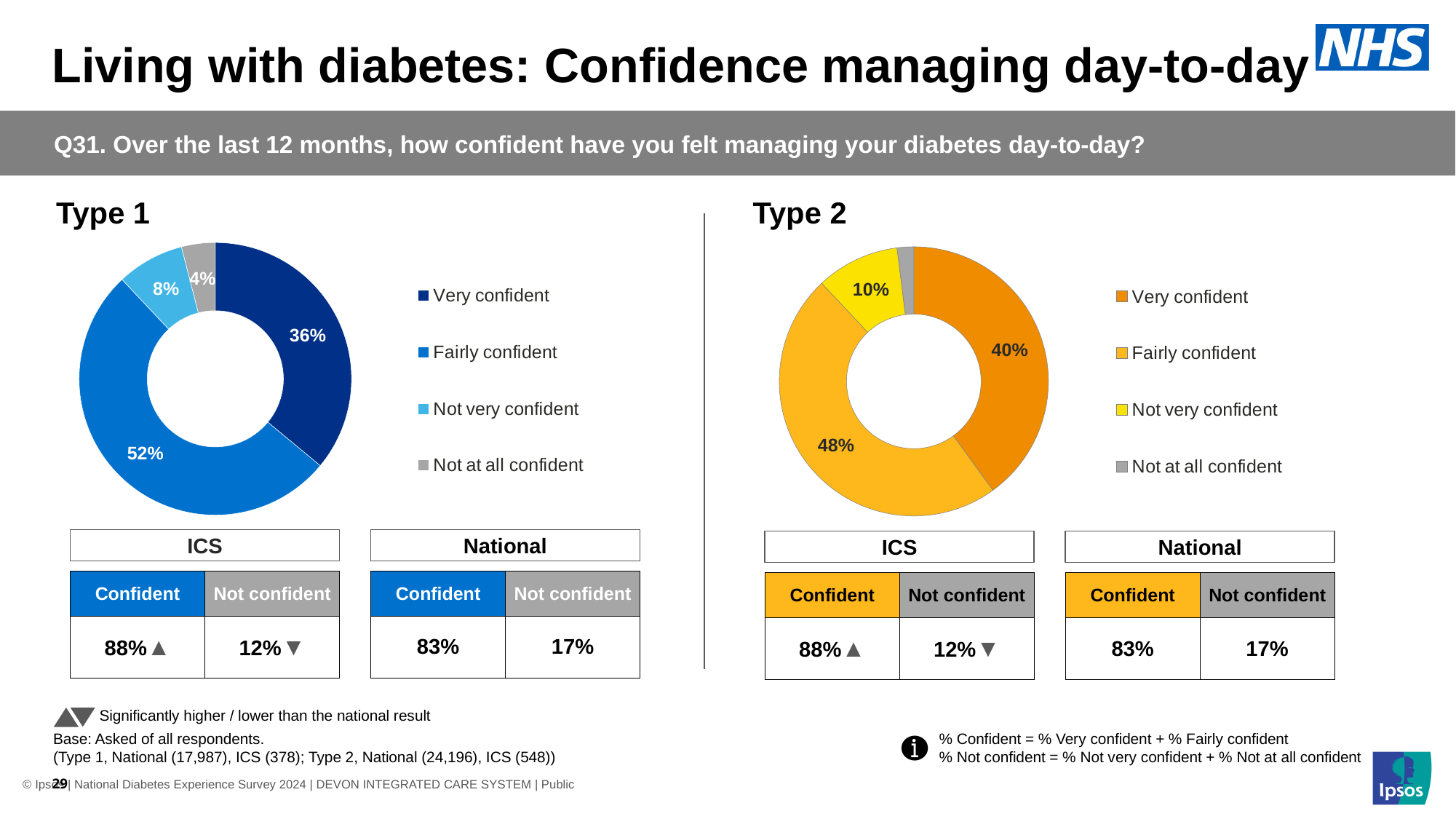
In the Type 1 chart, what percentage of respondents were fairly confident? 52% In the Type 2 chart, what percentage of respondents were very confident? 40% In the Type 2 chart, what percentage of respondents were not very confident? 10% In the Type 2 chart, which is larger: the share for very confident or for fairly confident? Fairly confident In the Type 1 chart, what percentage of respondents were very confident? 36% In the Type 1 chart, which category has the largest share? Fairly confident In the Type 2 chart, which category has the smallest share? Not at all confident How many categories does the legend of the Type 1 chart list? 4 In the Type 1 chart, what percentage of respondents were not at all confident? 4% In the Type 1 chart, what is the difference between the fairly confident and very confident shares? 16 percentage points What kind of chart is used for Type 2? Donut (pie) chart In the Type 2 chart, what colour represents the fairly confident category? Yellow-orange (amber)